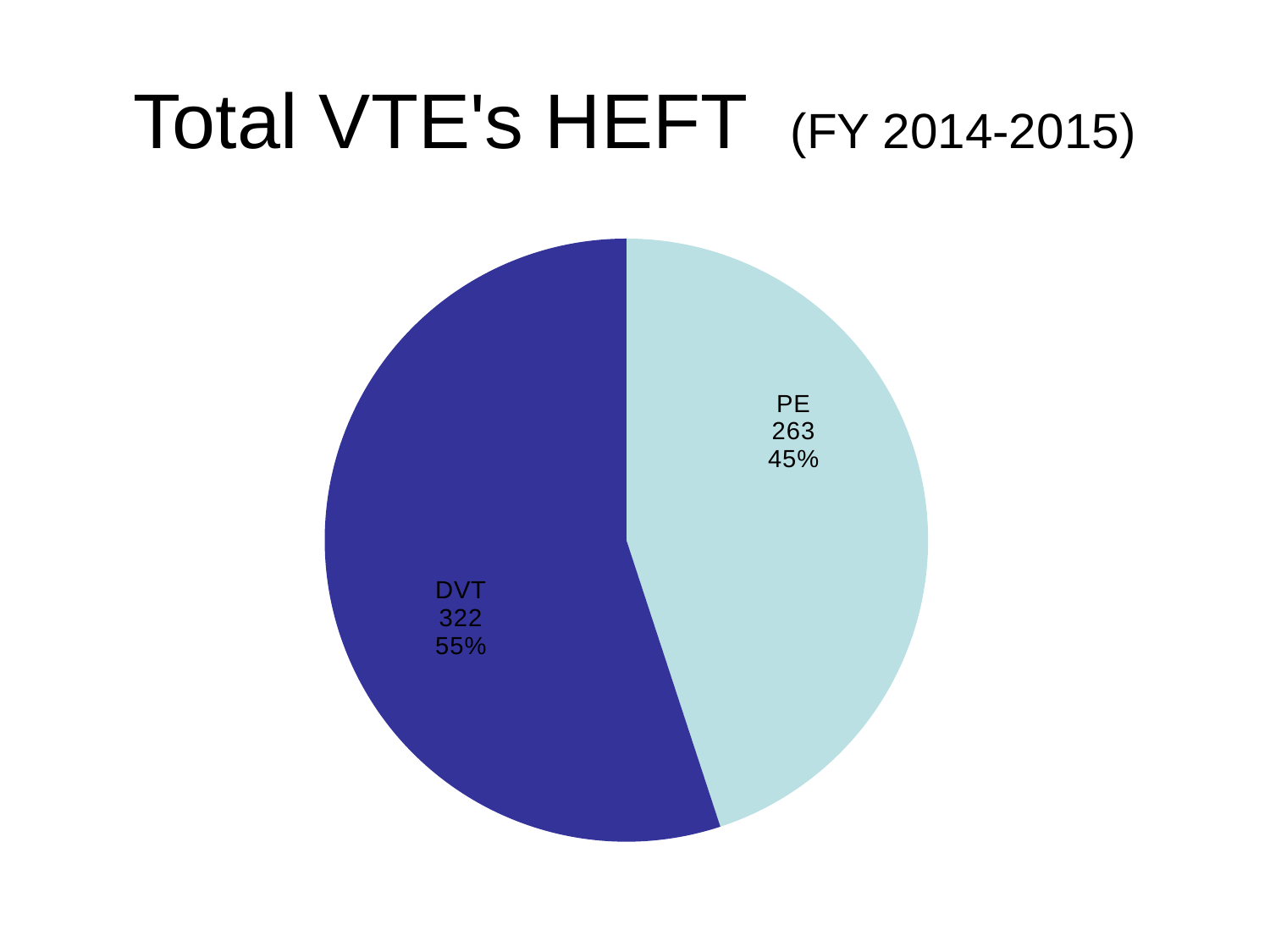
What is the total of the DVT and PE values? 585 Which category has the largest slice? DVT What share of the pie does DVT represent? 55% What is the difference between the DVT and PE values? 59 What is the title of the chart? Total VTE's HEFT (FY 2014-2015) What is the value for PE? 263 What is the value for DVT? 322 How many slices does the pie chart have? 2 Which category has the smallest slice? PE What type of chart is shown on the slide? pie chart Which is larger, the value for DVT or the value for PE? DVT What share of the pie does PE represent? 45%